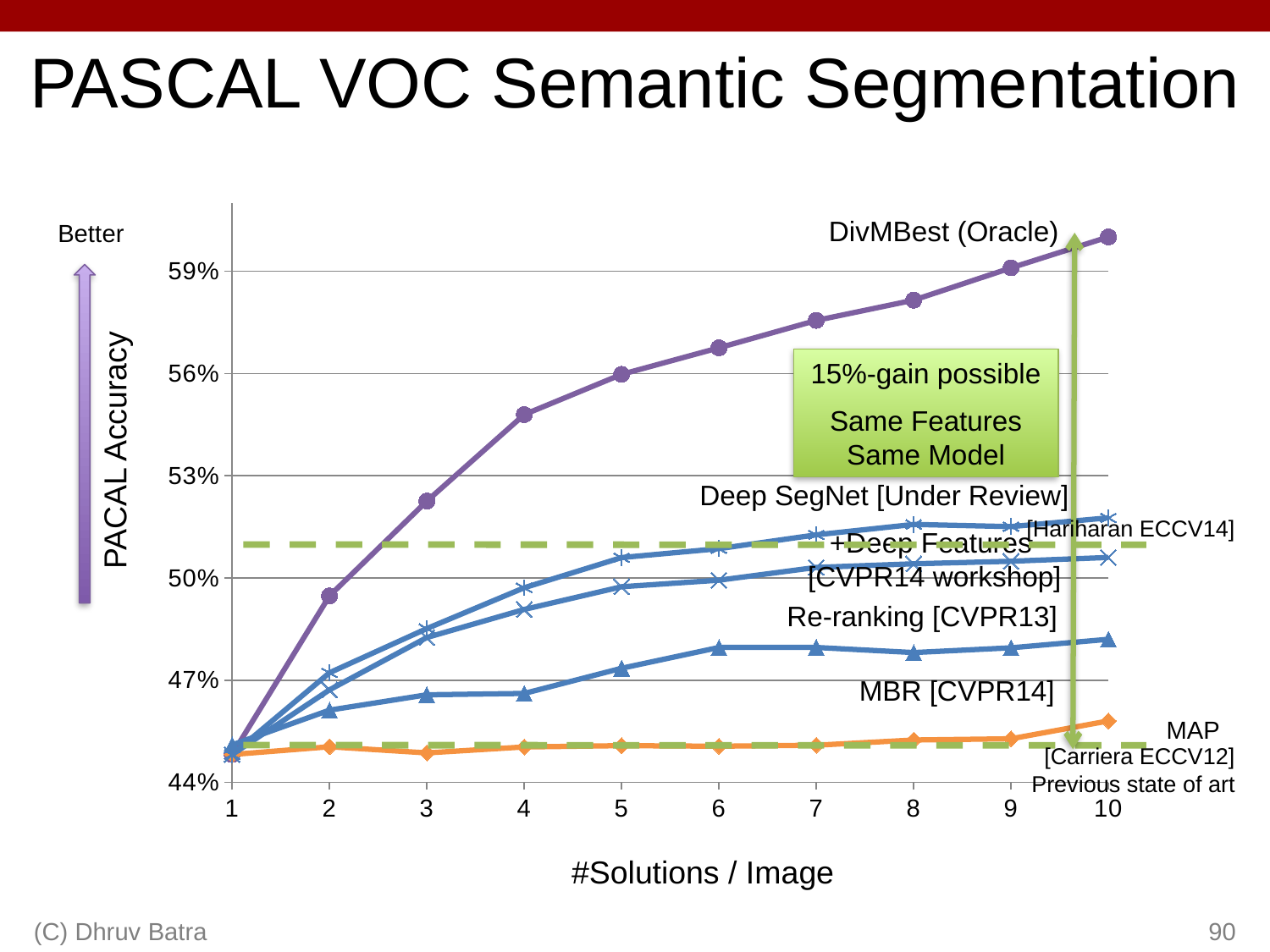
Is the value for MAP at 10 solutions per image greater or less than 47%? less Does the DivMBest (Oracle) line rise or fall as #Solutions / Image increases? rise Which series has the lowest accuracy at 10 solutions per image? MAP At 10 solutions per image, which is larger: DivMBest (Oracle) or MBR [CVPR14]? DivMBest (Oracle) What kind of chart is shown on the slide? line chart What is the label of the x axis? #Solutions / Image Is the value for DivMBest (Oracle) at 2 solutions per image greater or less than 50%? less Is the value for DivMBest (Oracle) at 10 solutions per image greater or less than 59%? greater Which series has the highest accuracy at 10 solutions per image? DivMBest (Oracle) How many values of #Solutions / Image are plotted along the x axis? 10